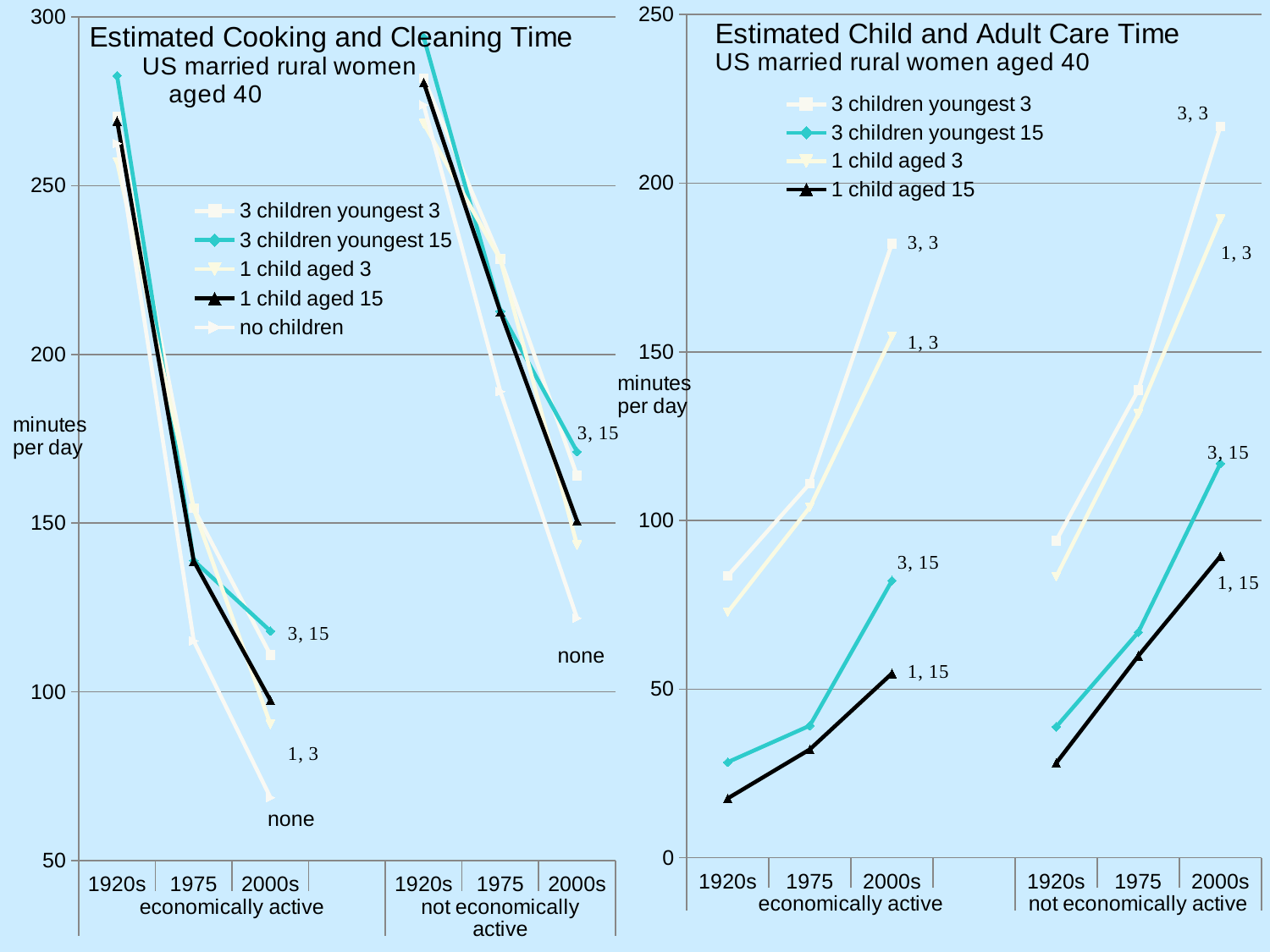
How many series does the legend of the 'Estimated Child and Adult Care Time' chart list? 4 How many series does the legend of the 'Estimated Cooking and Cleaning Time' chart list? 5 In the 'Estimated Child and Adult Care Time' chart, do the values for not economically active women rise or fall from the 1920s to the 2000s? rise How many time periods are shown on the x axis within each economic-activity group of the 'Estimated Child and Adult Care Time' chart? 3 In the 'Estimated Cooking and Cleaning Time' chart, is the 2000s value for 'no children' among economically active women greater or less than 100? less In the 'Estimated Child and Adult Care Time' chart, is the 2000s value for '3 children youngest 3' among not economically active women greater or less than 200? greater In the 'Estimated Child and Adult Care Time' chart, is the 1920s value for '3 children youngest 15' among economically active women greater or less than 50? less In the 'Estimated Child and Adult Care Time' chart, for not economically active women in the 2000s, which is larger: '3 children youngest 3' or '1 child aged 15'? 3 children youngest 3 What kind of chart is the 'Estimated Cooking and Cleaning Time' chart on the left? line chart What is the y-axis label on the 'Estimated Cooking and Cleaning Time' chart? minutes per day In the 'Estimated Cooking and Cleaning Time' chart, do the values for economically active women rise or fall from the 1920s to the 2000s? fall